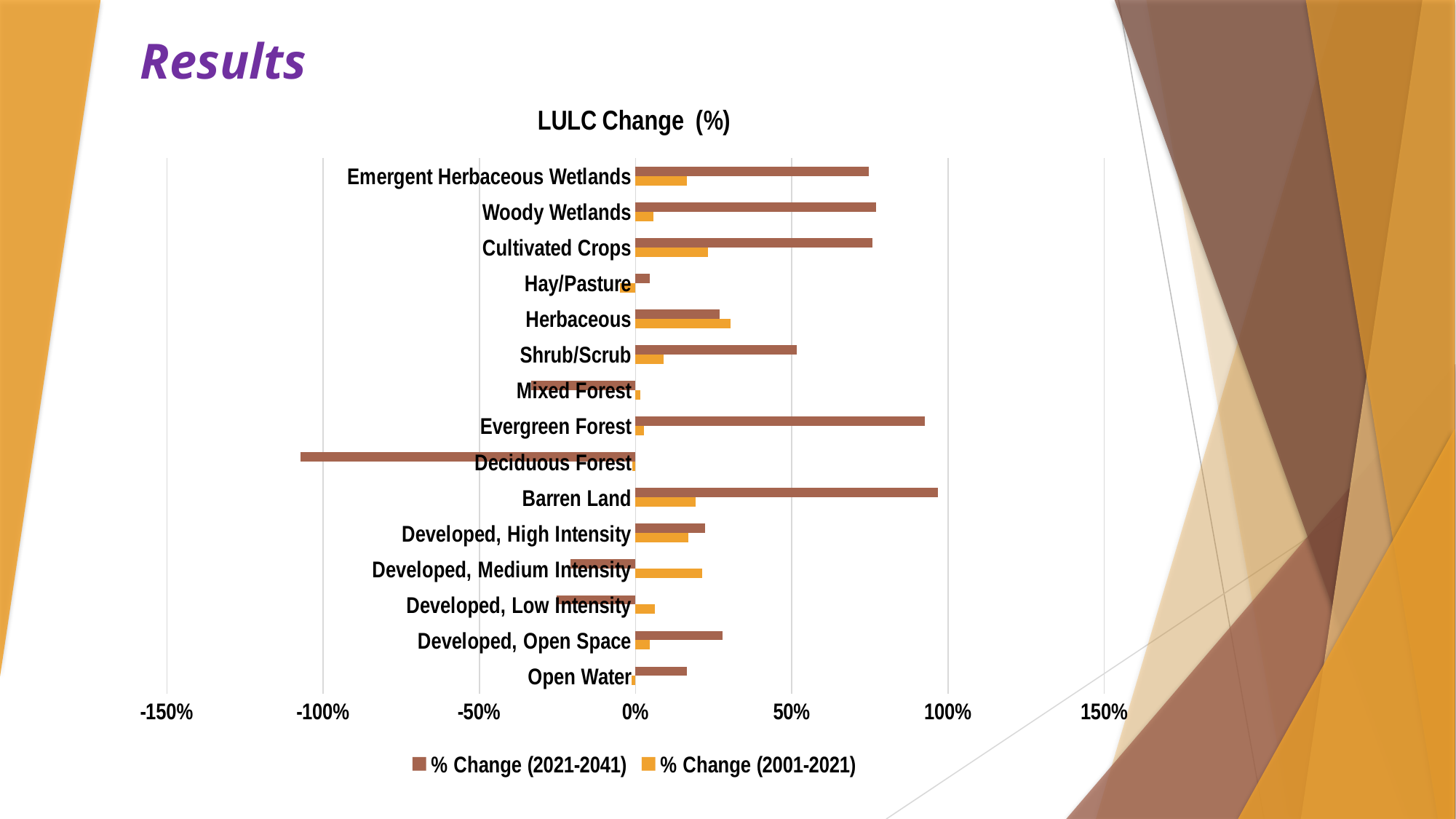
Is the % Change (2021-2041) value for Emergent Herbaceous Wetlands greater or less than 50%? greater Is the % Change (2021-2041) value for Deciduous Forest greater or less than -100%? less Which category has the lowest value for % Change (2021-2041)? Deciduous Forest How many land cover categories are plotted in the chart? 15 How many series does the legend list? 2 For Herbaceous, which series has the larger value: % Change (2021-2041) or % Change (2001-2021)? % Change (2001-2021) What kind of chart is shown on the slide? bar chart What is the title of the chart? LULC Change (%) For Cultivated Crops, which series has the larger value: % Change (2021-2041) or % Change (2001-2021)? % Change (2021-2041) Which category has the highest value for % Change (2001-2021)? Herbaceous Is the % Change (2001-2021) value for Herbaceous greater or less than 50%? less